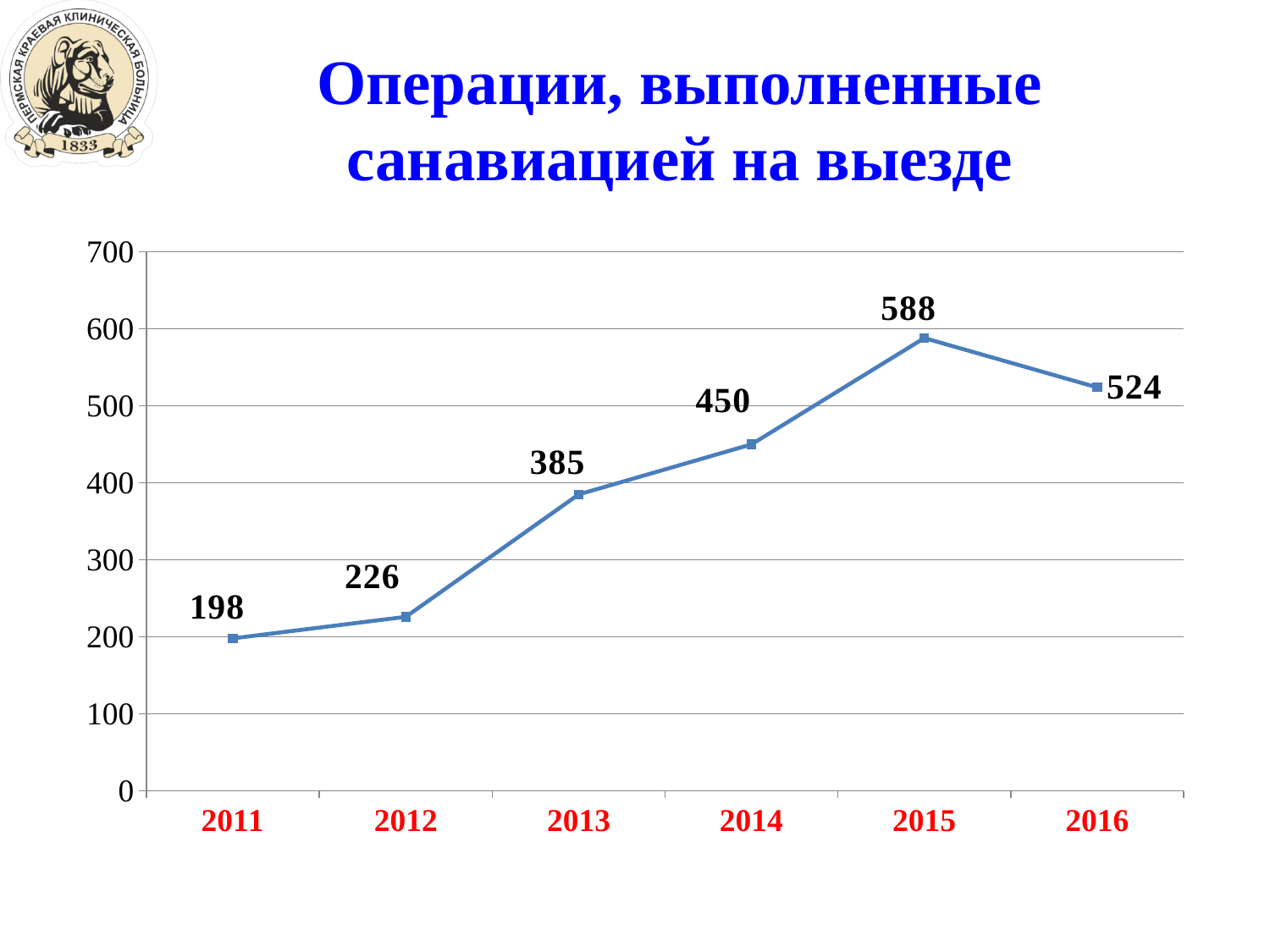
What is the value for 2016? 524 Do the values rise or fall from 2011 to 2015? rise What is the value for 2011? 198 Is the value for 2015 greater or less than 500? greater How many years are plotted on the chart? 6 What is the difference between the values for 2015 and 2016? 64 Which is larger, the value for 2014 or the value for 2013? 2014 Which year has the highest value? 2015 What kind of chart is shown on the slide? line chart What is the value for 2014? 450 What is the difference between the values for 2013 and 2012? 159 Which year has the lowest value? 2011